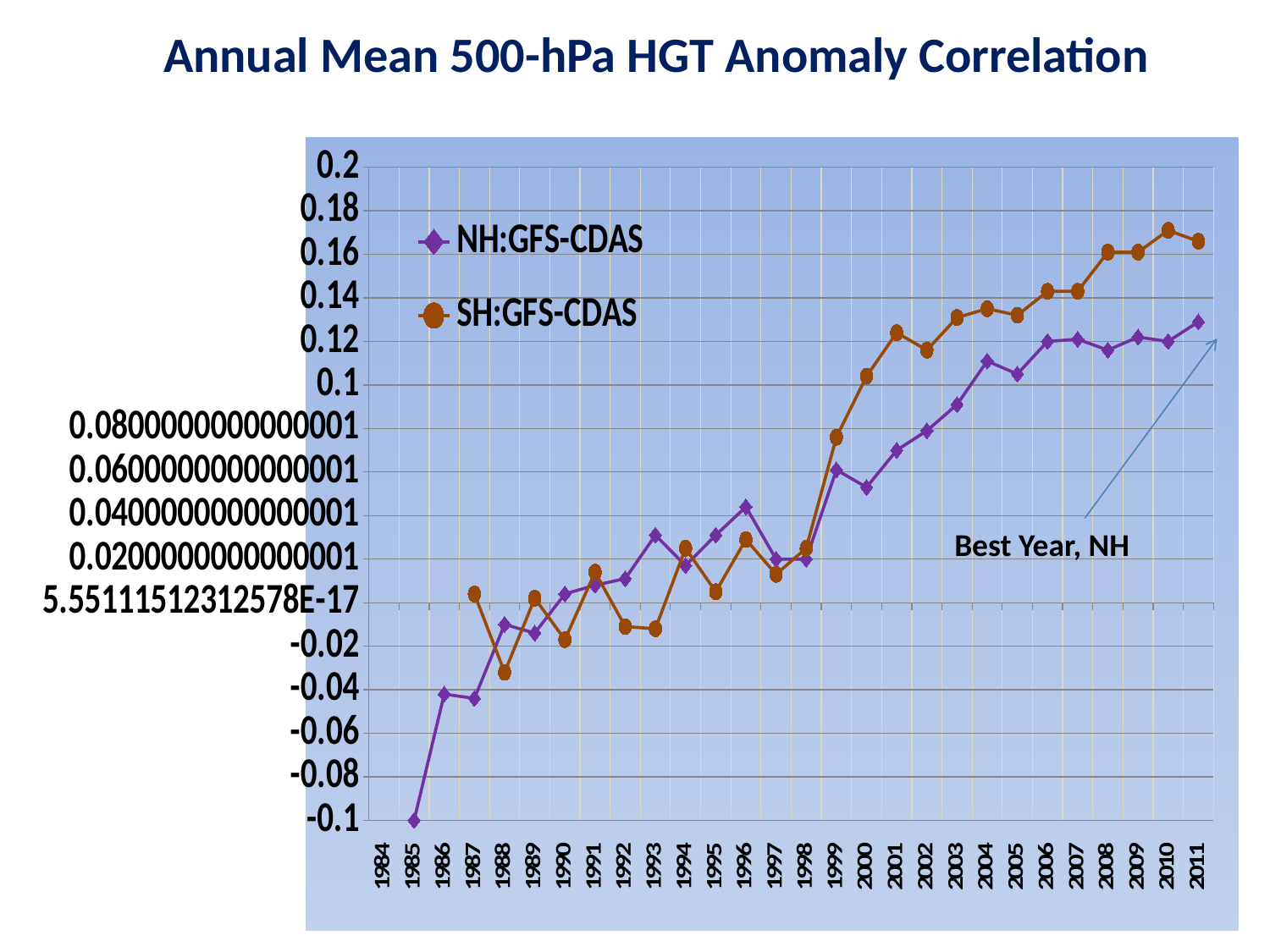
How many series does the legend list? 2 In which year is the SH:GFS-CDAS value highest? 2010 What is the title of the chart? Annual Mean 500-hPa HGT Anomaly Correlation In which year is the SH:GFS-CDAS value lowest? 1988 Is the SH:GFS-CDAS value for 2010 greater or less than 0.16? greater Is the NH:GFS-CDAS value for 1985 greater or less than -0.08? less In 1993, which series has the larger value, NH:GFS-CDAS or SH:GFS-CDAS? NH:GFS-CDAS What kind of chart is shown on the slide? line chart Overall, do the values for NH:GFS-CDAS rise or fall from 1985 to 2011? rise What are the two series named in the legend? NH:GFS-CDAS and SH:GFS-CDAS In 2010, which series has the larger value, NH:GFS-CDAS or SH:GFS-CDAS? SH:GFS-CDAS